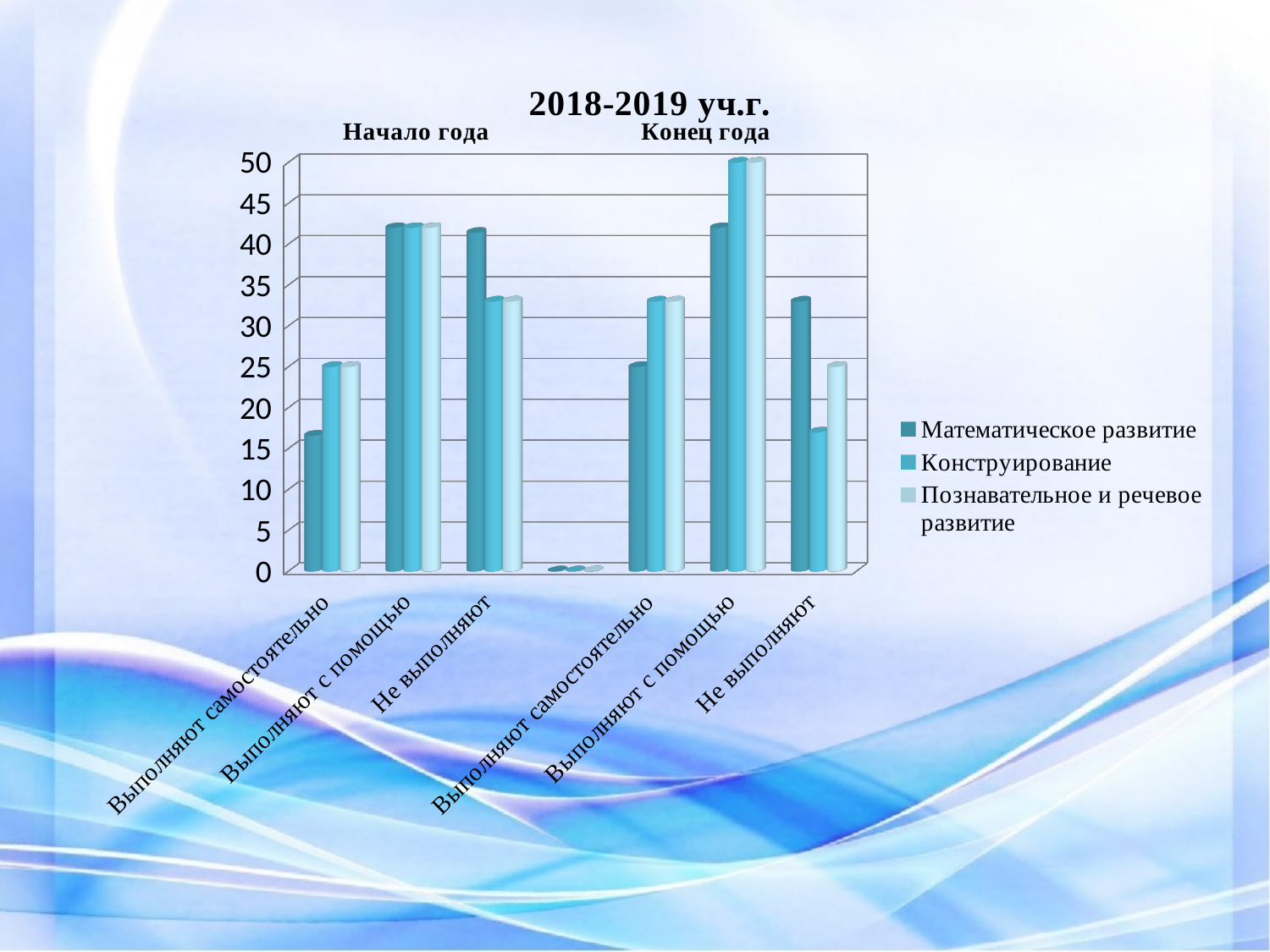
Is the value for Математическое развитие in the "Не выполняют" category under Начало года greater or less than 35? greater Is the value for Математическое развитие in the "Выполняют самостоятельно" category under Начало года greater or less than 20? less Across the whole chart, in which category (and period) is the Математическое развитие bar the lowest? Выполняют самостоятельно (Начало года) Which series are listed in the chart legend? Математическое развитие, Конструирование, Познавательное и речевое развитие Is the value for Конструирование in the "Не выполняют" category under Конец года greater or less than 20? less What kind of chart is shown on the slide? bar chart In the "Не выполняют" category under Конец года, which is larger: Математическое развитие or Познавательное и речевое развитие? Математическое развитие What is the title of the chart? 2018-2019 уч.г. In the "Выполняют самостоятельно" category under Начало года, which is larger: Математическое развитие or Конструирование? Конструирование How many series does the chart legend list? 3 Under Конец года, in which category is the Конструирование bar the highest? Выполняют с помощью